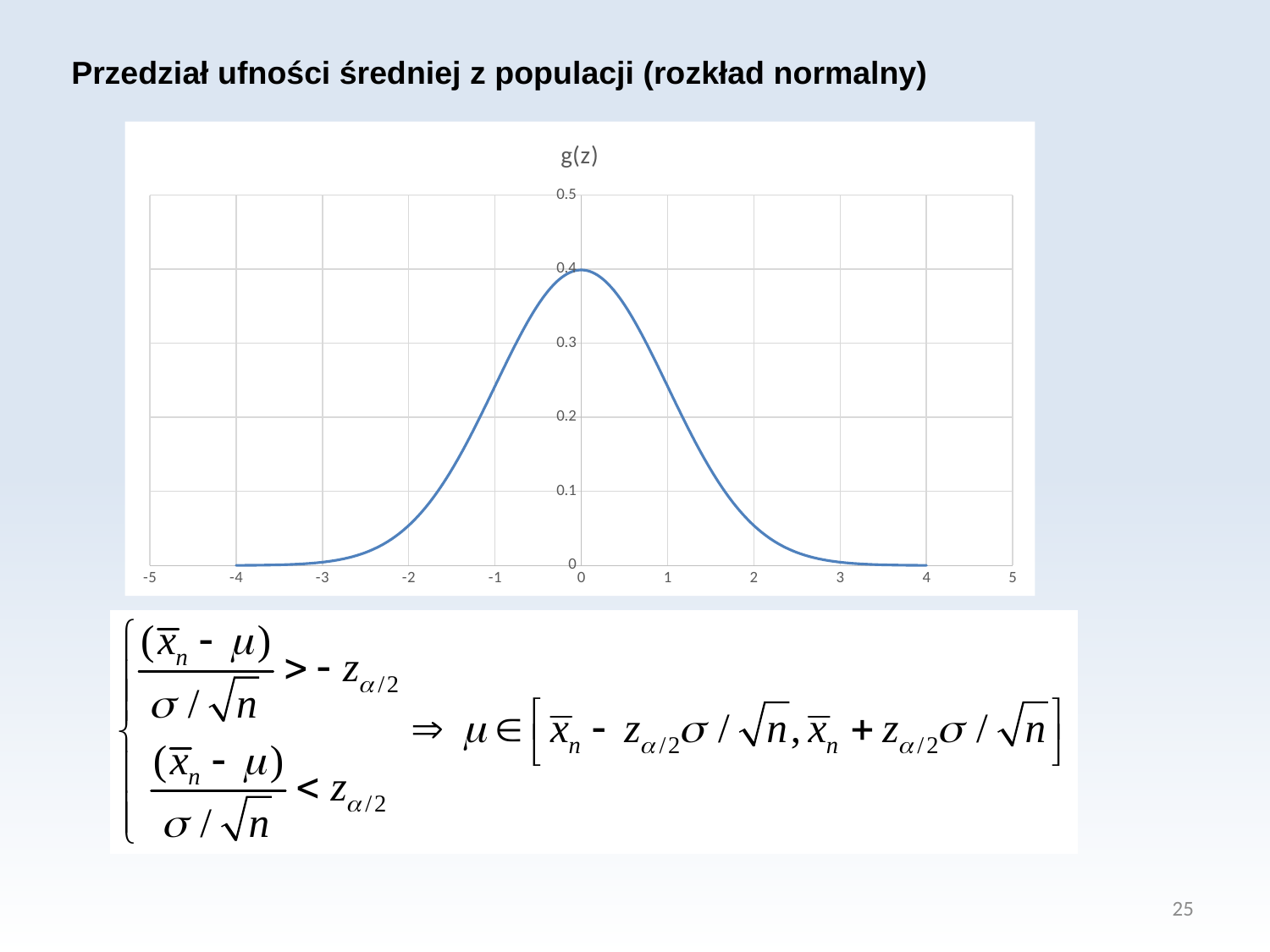
What is the highest value shown on the vertical axis of the chart? 0.5 Is the value of g(z) at z = 3 greater or less than 0.1? less Which is larger, g(z) at z = 1 or g(z) at z = 2? z = 1 Is the value of g(z) at z = -1 greater or less than 0.2? greater Is the value of g(z) at z = 0 greater or less than 0.3? greater Does the curve rise or fall as z goes from 0 to 4? fall What kind of chart is shown on the slide? line chart At which value of z does the curve g(z) reach its highest point? 0 Does the curve rise or fall as z goes from -4 to 0? rise What is the title of the chart? g(z)